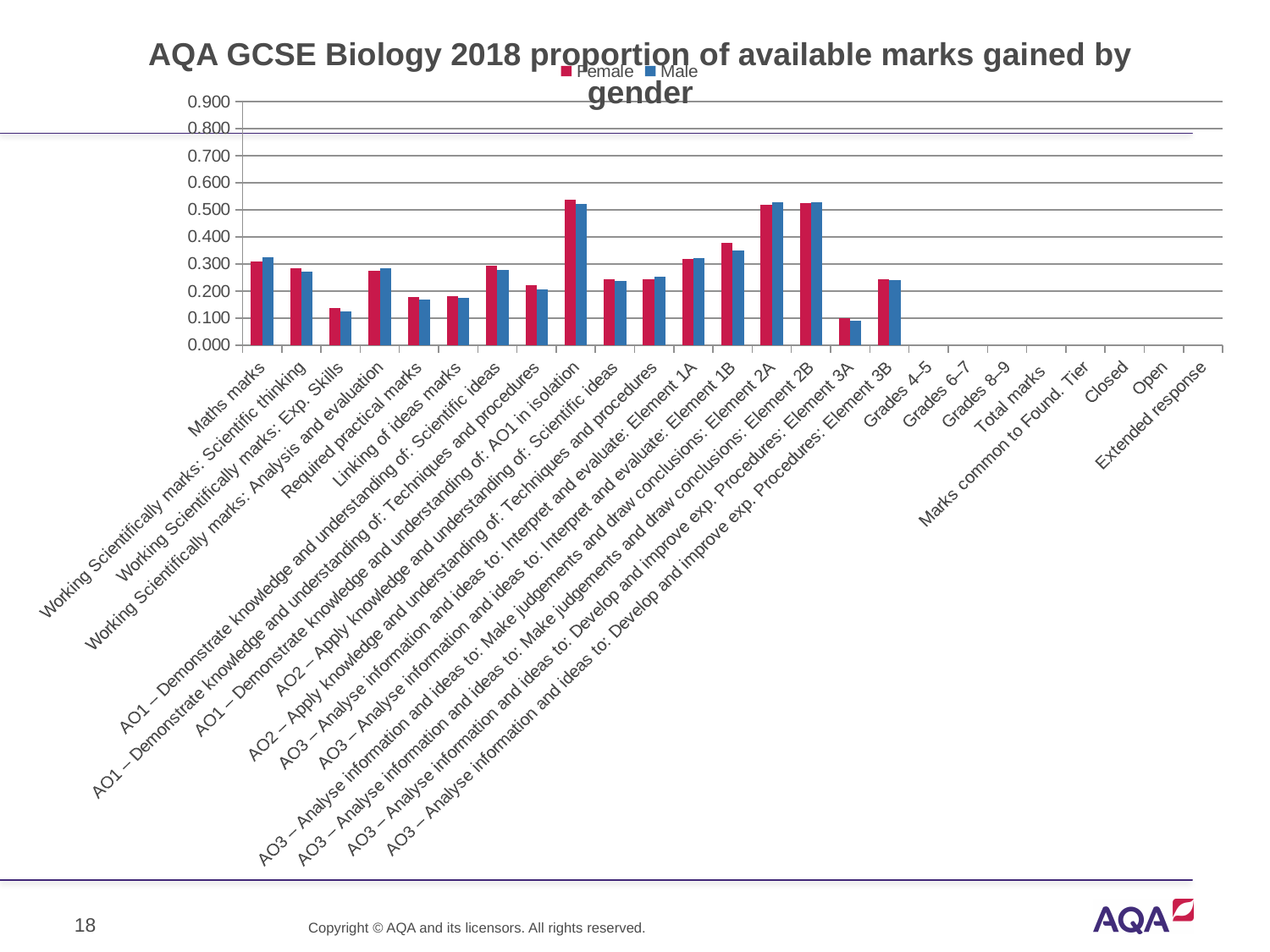
Is the Female value for Working Scientifically marks: Exp. Skills greater or less than 0.200? less Is the Female value for Element 1B greater or less than 0.300? greater Is the Female value for AO1 in isolation greater or less than 0.500? greater Among the categories with plotted bars, which has the lowest proportion of available marks gained? AO3 – Analyse information and ideas to: Develop and improve exp. Procedures: Element 3A Which category has the highest proportion of available marks gained? AO1 – Demonstrate knowledge and understanding of: AO1 in isolation For Element 1B, which is higher, the Female or the Male value? Female Which series is shown in red? Female How many series does the legend list? 2 For Maths marks, which is higher, the Female or the Male value? Male What kind of chart is shown on the slide? bar chart How many categories are listed on the x axis? 25